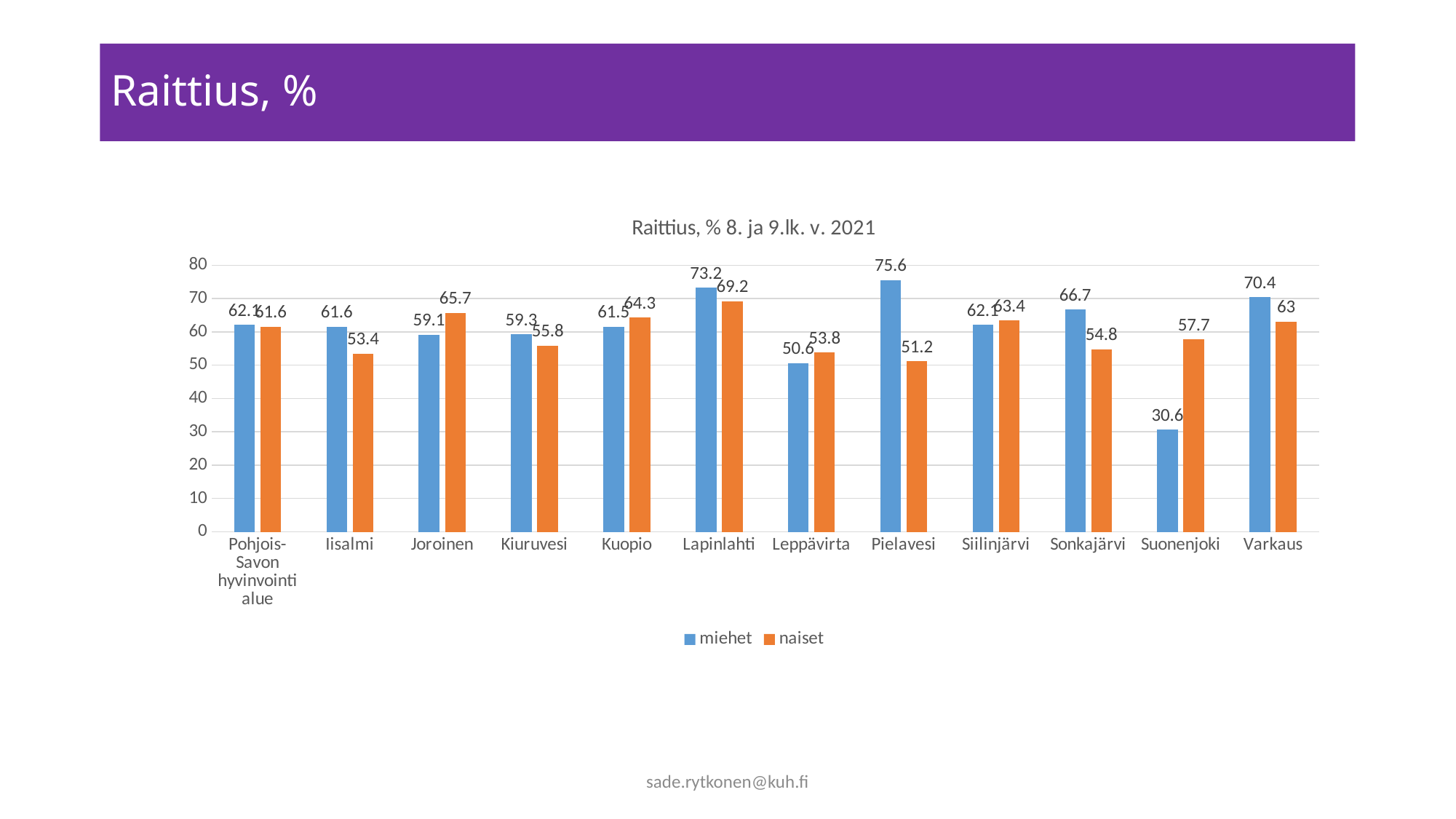
What is the value for naiset in Varkaus? 63 Which category has the highest value for naiset? Lapinlahti How many categories are shown on the x axis? 12 What is the value for naiset in Suonenjoki? 57.7 Which is larger in Sonkajärvi, the value for miehet or for naiset? miehet Which category has the lowest value for miehet? Suonenjoki What is the value for miehet in Pielavesi? 75.6 What is the difference between the naiset and miehet values in Suonenjoki? 27.1 What is the value for miehet in Lapinlahti? 73.2 How many series does the legend list? 2 Which category has the highest value for miehet? Pielavesi What kind of chart is shown on the slide? bar chart